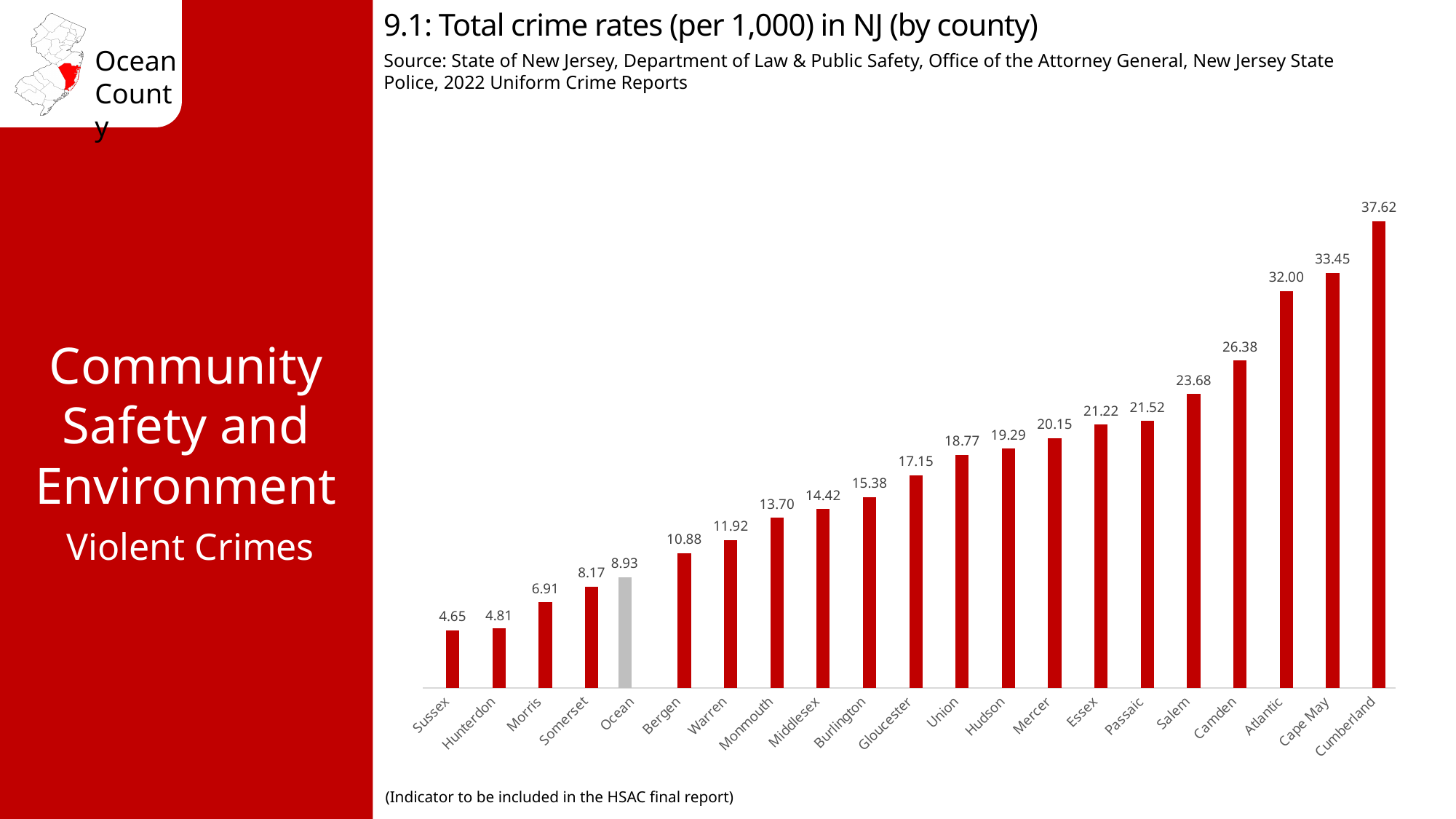
Which county has the highest total crime rate on the chart? Cumberland Which county has a higher total crime rate, Hudson or Monmouth? Hudson Which county's bar is coloured grey instead of red? Ocean What is the total crime rate (per 1,000) for Bergen County? 10.88 What is the difference between the total crime rates of Cumberland and Sussex? 32.97 Which county has the lowest total crime rate on the chart? Sussex What type of chart is shown on the slide? Bar chart What is the difference between the total crime rates of Cape May and Atlantic? 1.45 What is the total crime rate (per 1,000) for Essex County? 21.22 Do the total crime rates rise or fall moving from left to right along the x axis? Rise What is the total crime rate (per 1,000) for Ocean County? 8.93 How many counties are shown on the chart? 21